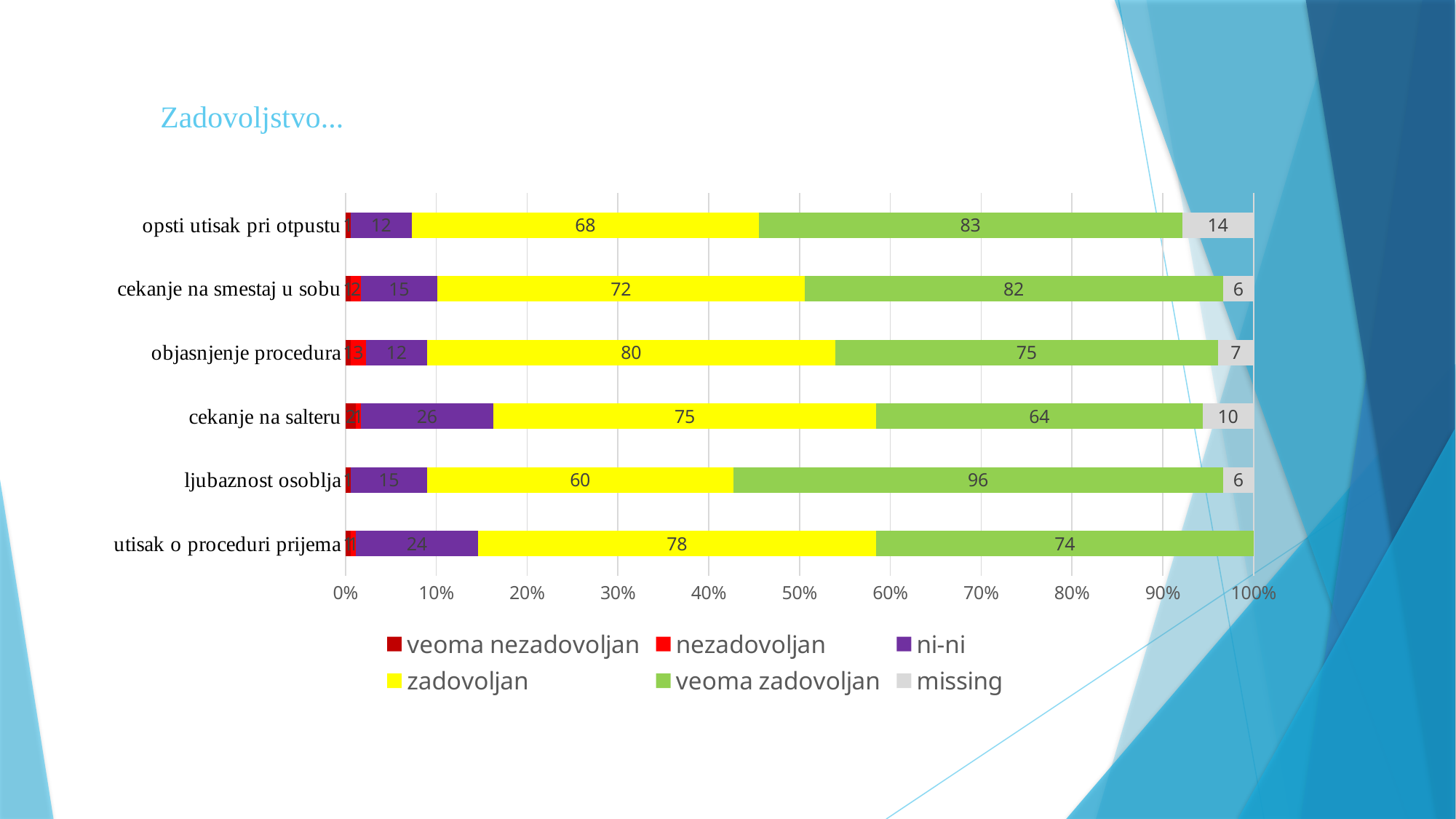
Which category has the highest 'veoma zadovoljan' value? ljubaznost osoblja What is the difference between the 'veoma zadovoljan' values for 'opsti utisak pri otpustu' and 'cekanje na salteru'? 19 What kind of chart is shown on the slide? Stacked bar chart How many series does the legend list? 6 What is the 'missing' value for 'opsti utisak pri otpustu'? 14 Which category has the highest 'ni-ni' value? cekanje na salteru What is the value of the 'veoma zadovoljan' series for 'ljubaznost osoblja'? 96 Which has the larger 'zadovoljan' value: 'cekanje na smestaj u sobu' or 'utisak o proceduri prijema'? utisak o proceduri prijema How many categories are shown on the chart? 6 What is the value of the 'zadovoljan' series for 'objasnjenje procedura'? 80 Which category has the lowest 'zadovoljan' value? ljubaznost osoblja What is the 'ni-ni' value for 'cekanje na salteru'? 26